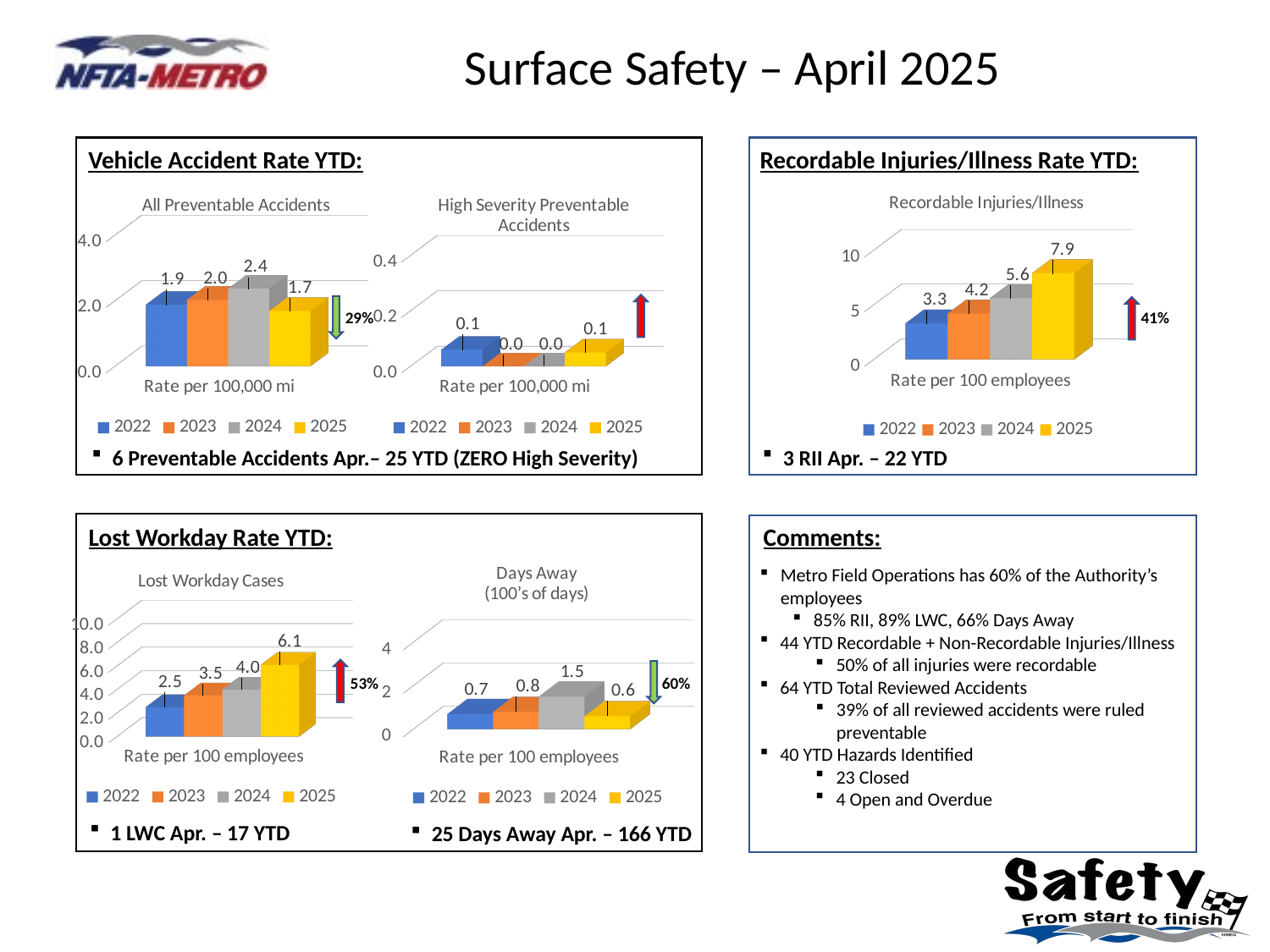
In the "High Severity Preventable Accidents" chart, what is the value for 2023? 0.0 In the "Days Away (100's of days)" chart, which year has the highest value? 2024 In the "All Preventable Accidents" chart, which year has the highest value? 2024 In the "All Preventable Accidents" chart, what is the value for 2025? 1.7 In the "Recordable Injuries/Illness" chart, what is the difference between the 2025 and 2024 values? 2.3 In the "Lost Workday Cases" chart, what is the value for 2023? 3.5 In the "Recordable Injuries/Illness" chart, what is the value for 2025? 7.9 How many series does the legend of the "Recordable Injuries/Illness" chart list? 4 In the "Recordable Injuries/Illness" chart, which year has the lowest value? 2022 In the "Days Away (100's of days)" chart, which is larger, the value for 2022 or the value for 2024? 2024 In the "Lost Workday Cases" chart, is the value for 2025 greater or less than 4.0? greater What kind of chart is the "Lost Workday Cases" chart? Bar chart